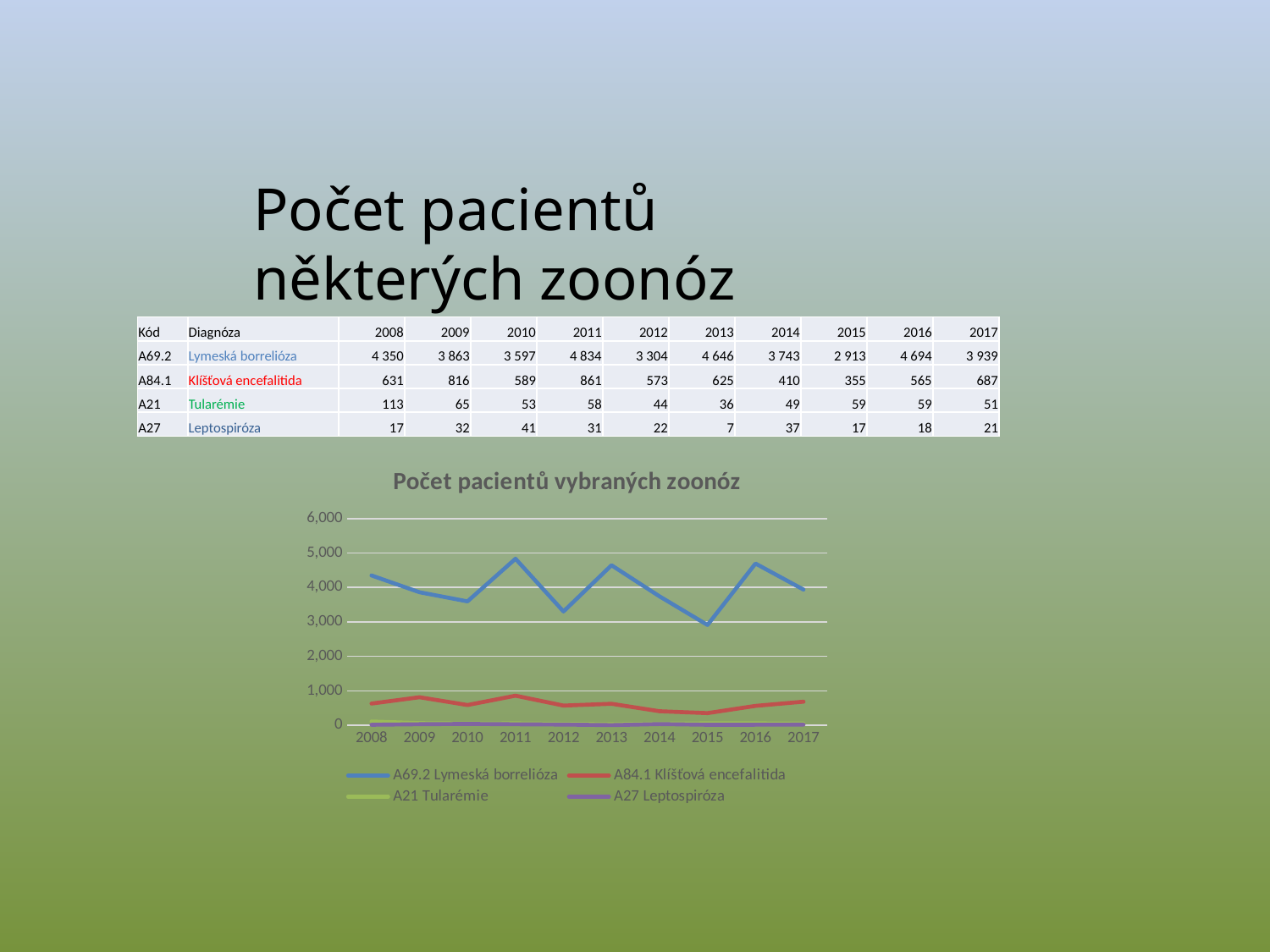
What is the value for A21 Tularémie in 2008? 113 Does the A84.1 Klíšťová encefalitida series rise or fall from 2015 to 2017? rise In which year does the A69.2 Lymeská borrelióza series reach its highest value? 2011 How many years are plotted along the x axis of the chart? 10 Which year has the larger value for A69.2 Lymeská borrelióza, 2013 or 2014? 2013 Is the value for A69.2 Lymeská borrelióza in 2012 greater or less than 4,000? less In which year does the A69.2 Lymeská borrelióza series reach its lowest value? 2015 What is the difference between the A69.2 Lymeská borrelióza values for 2008 and 2009? 487 What is the value for A84.1 Klíšťová encefalitida in 2011? 861 What kind of chart is shown on the slide? line chart What is the title of the chart? Počet pacientů vybraných zoonóz How many series does the chart legend list? 4